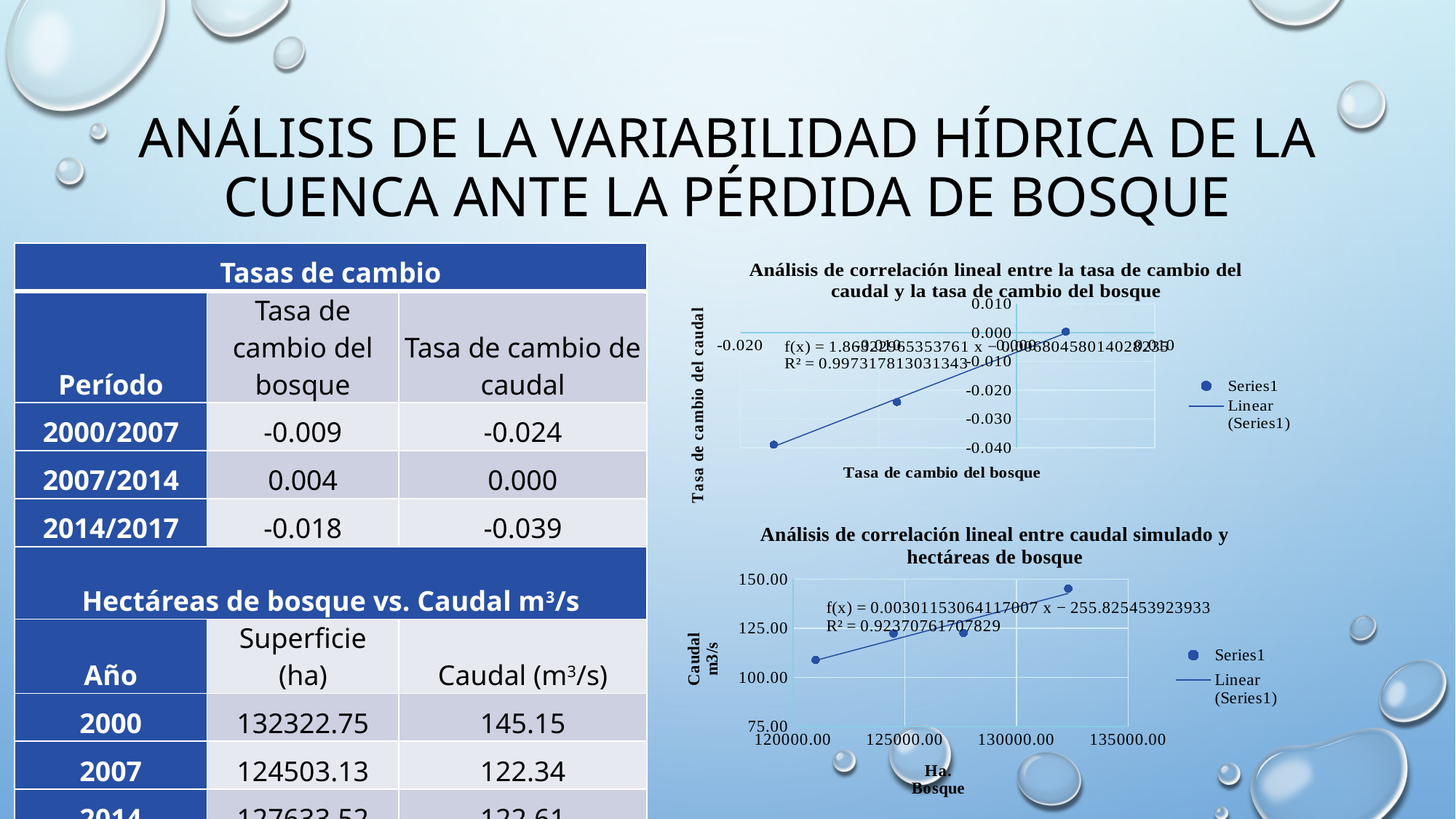
In the bottom chart, is the caudal value for the point with the largest Ha. Bosque greater or less than 125.00? greater How many data points are plotted in the top chart (tasa de cambio del caudal vs. tasa de cambio del bosque)? 3 In the top chart, does the tasa de cambio del caudal rise or fall as the tasa de cambio del bosque increases? Rise What R² value is shown on the top chart? R² = 0.997317813031343 In the top chart, is the tasa de cambio del caudal for the point with the lowest tasa de cambio del bosque greater or less than -0.030? less In the bottom chart, is the caudal value for the point with the smallest Ha. Bosque greater or less than 125.00? less In the bottom chart, does caudal rise or fall as Ha. Bosque increases along the x axis? Rise In the bottom chart, which point has the higher caudal: the one with the largest Ha. Bosque or the one with the smallest Ha. Bosque? The one with the largest Ha. Bosque What kind of chart is the top chart, 'Análisis de correlación lineal entre la tasa de cambio del caudal y la tasa de cambio del bosque'? Scatter chart with a linear trendline How many entries does the legend of the bottom chart list? 2 What R² value is shown on the bottom chart? R² = 0.92370761707829 How many data points are plotted in the bottom chart (caudal simulado vs. hectáreas de bosque)? 4